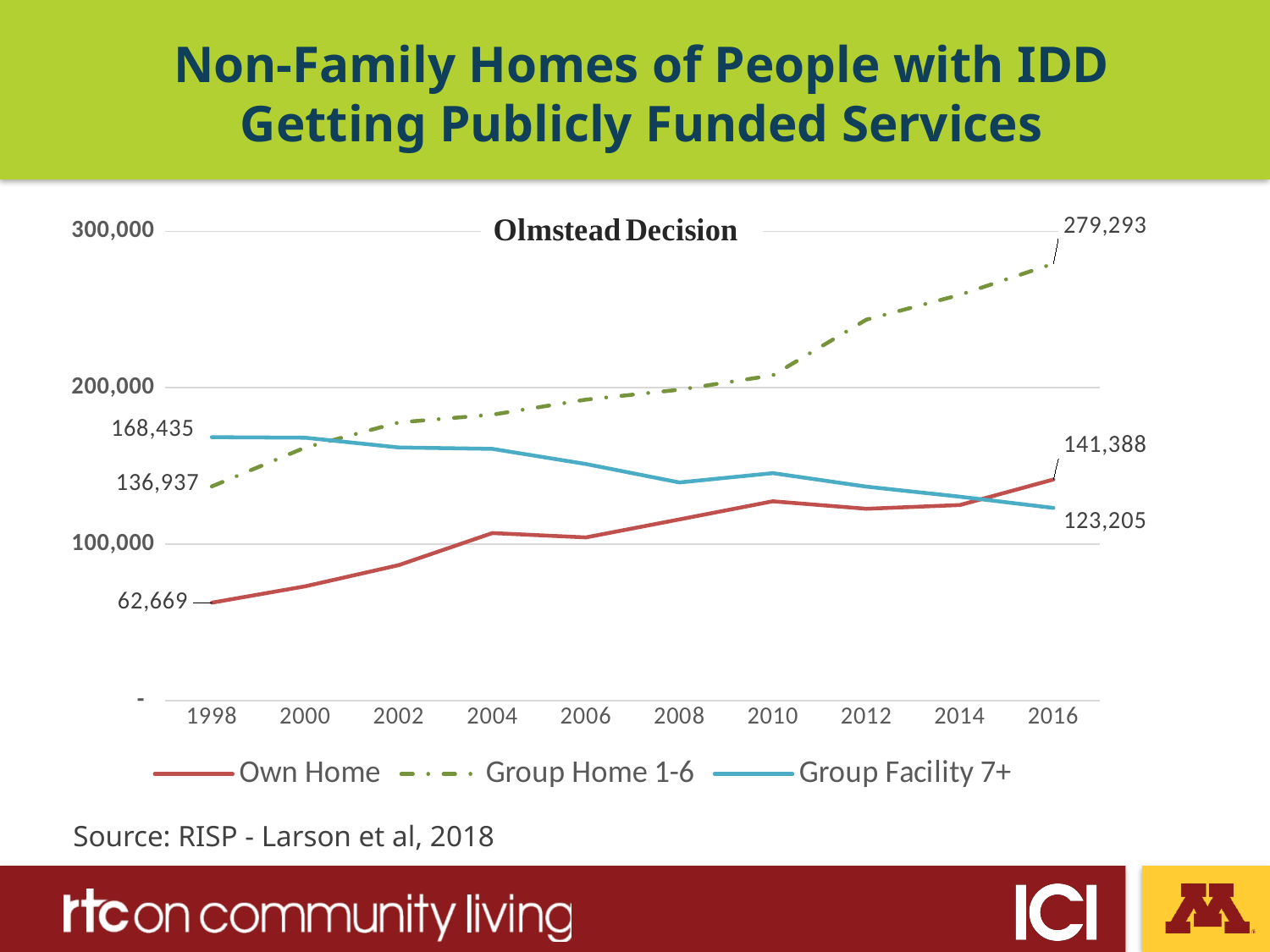
What is the value for Own Home in 1998? 62,669 What is the difference between the Own Home values in 2016 and 1998? 78,719 Does the Group Facility 7+ line rise or fall from 1998 to 2016? Fall Which series has the highest value in 2016? Group Home 1-6 What event is labelled at the top of the chart? Olmstead Decision What type of chart is shown on the slide? Line chart Which series has the lowest value in 1998? Own Home What is the value for Group Home 1-6 in 2016? 279,293 How many series does the legend list? 3 Is the value for Group Home 1-6 in 2010 greater or less than 200,000? greater What is the value for Group Facility 7+ in 1998? 168,435 What is the value for Group Facility 7+ in 2016? 123,205